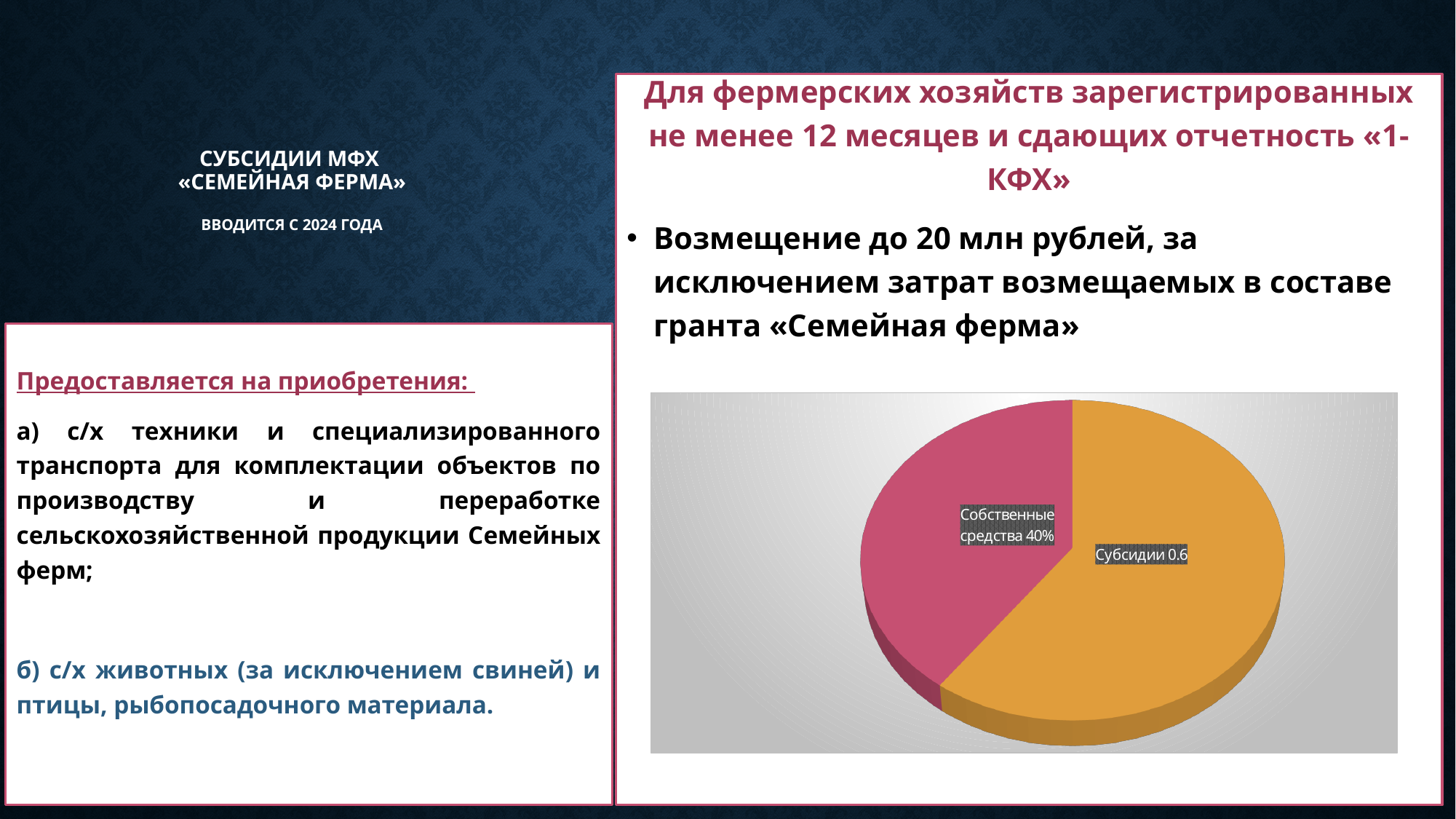
What share of the pie does the «Собственные средства» slice represent? 40% Which slice of the pie chart is the largest? Субсидии What colour is the «Собственные средства» slice in the pie chart? Pink How many slices does the pie chart have? 2 What value is labelled for the «Собственные средства» slice of the pie chart? 40% Which is larger in the pie chart: «Субсидии» or «Собственные средства»? Субсидии What value is labelled for the «Субсидии» slice of the pie chart? 0.6 What colour is the «Субсидии» slice in the pie chart? Orange What kind of chart is shown on the slide? Pie chart Which slice of the pie chart is the smallest? Собственные средства